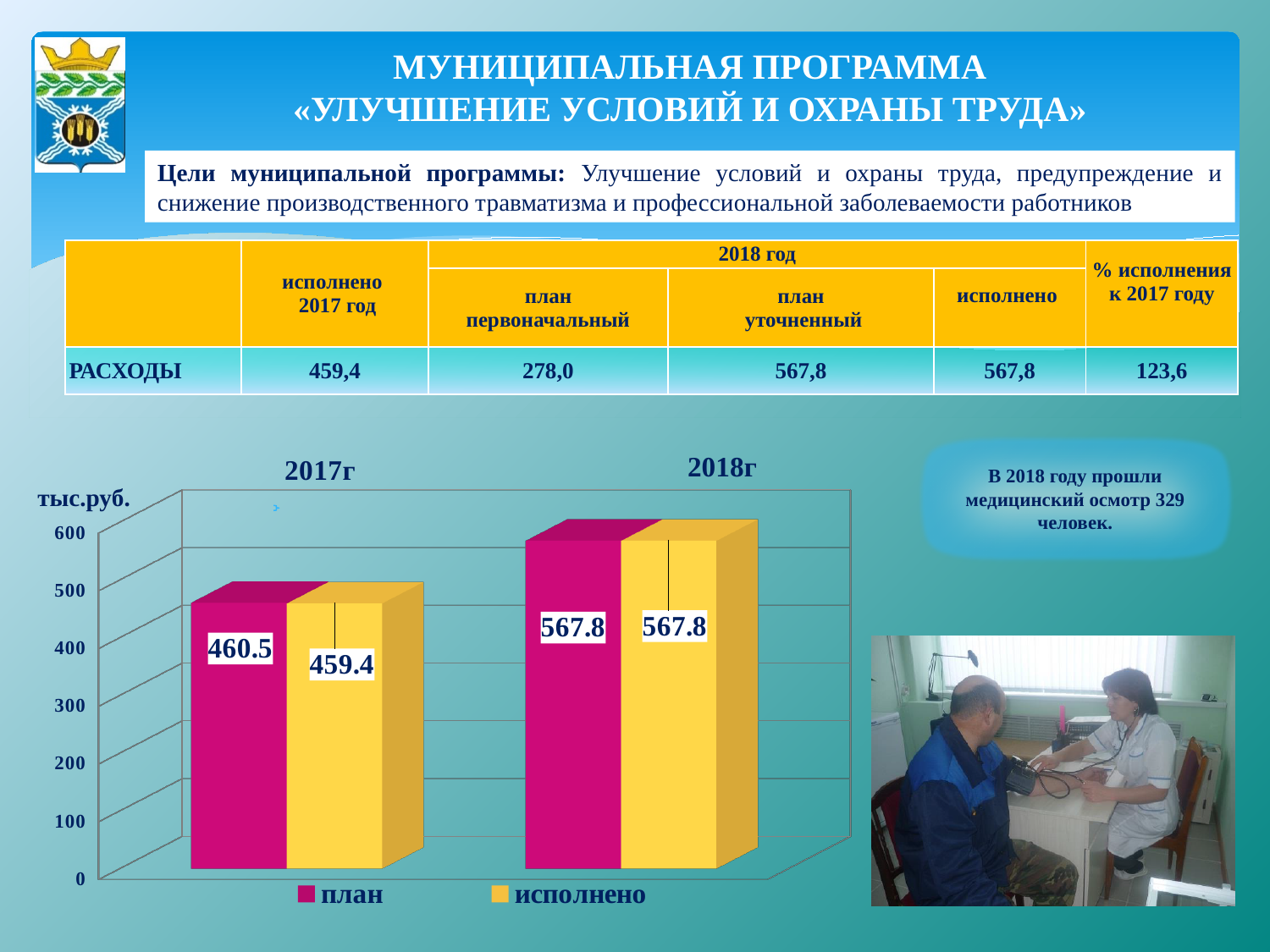
What is the value of the план bar for 2017г in the chart? 460.5 What is the value of the план bar for 2018г in the chart? 567.8 Is the план value for 2018г greater or less than 500 in the chart? greater What is the difference between the план and исполнено values for 2017г in the chart? 1.1 What is the value of the исполнено bar for 2017г in the chart? 459.4 By how much does the исполнено value for 2018г exceed the исполнено value for 2017г in the chart? 108.4 What kind of chart is shown on the slide? bar chart What is the value of the исполнено bar for 2018г in the chart? 567.8 How many series does the chart legend list? 2 What unit is shown on the vertical axis of the chart? тыс.руб. Which year has the higher исполнено value in the chart, 2017г or 2018г? 2018г How many year categories are shown on the x axis of the chart? 2